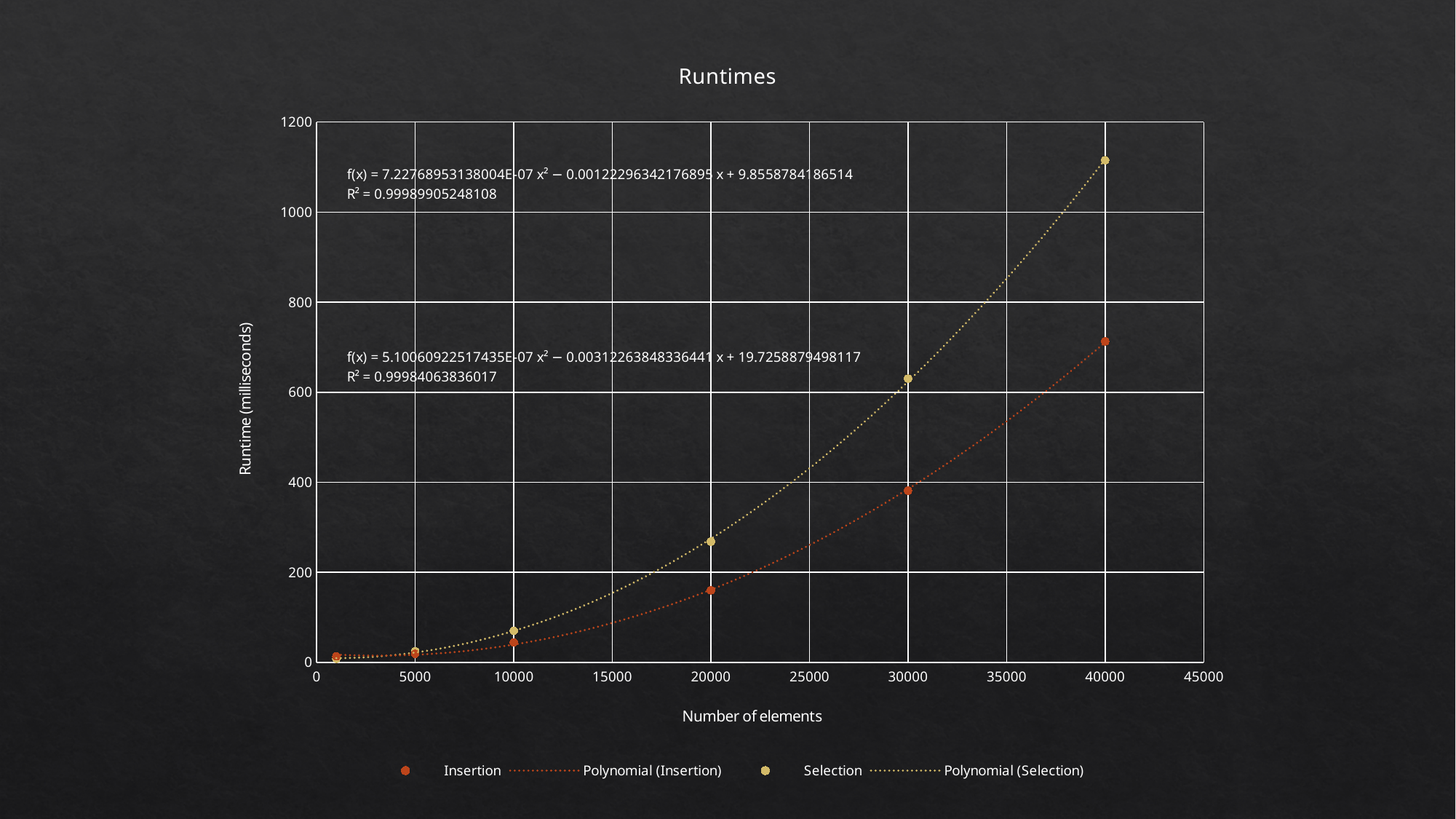
At which number of elements is the Selection runtime highest? 40000 At 40000 elements, which series has the larger runtime, Insertion or Selection? Selection What kind of chart is shown on the slide? scatter chart Is the Insertion runtime at 30000 elements greater or less than 400? less How many data points are plotted for the Selection series? 6 Is the Insertion runtime at 40000 elements greater or less than 800? less Do the runtimes rise or fall as the number of elements increases? rise Is the Insertion runtime at 20000 elements greater or less than 200? less How many entries does the chart legend list? 4 What is the title of the chart? Runtimes